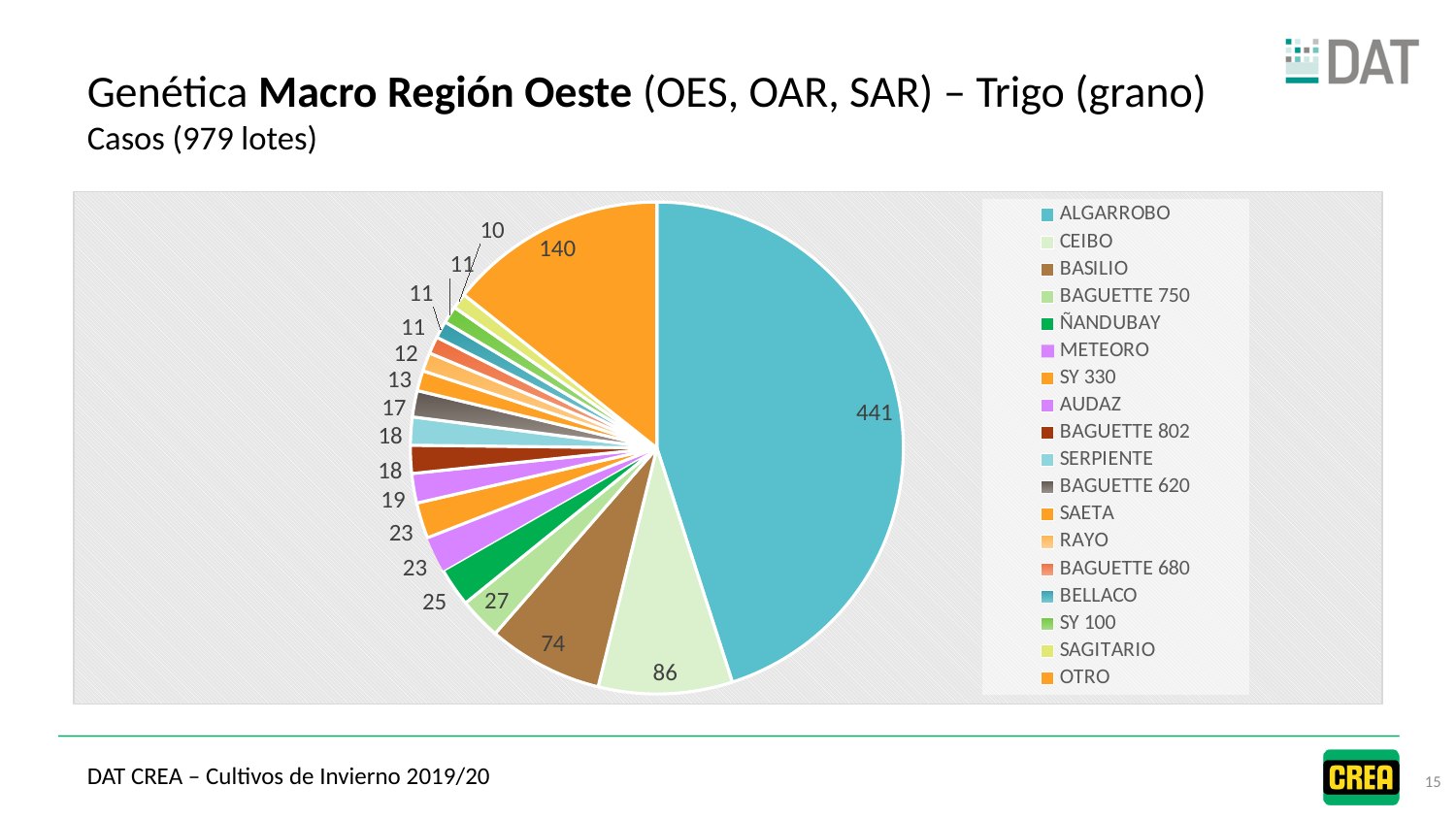
What is the value of the OTRO slice? 140 Which variety has the smallest slice of the pie? SAGITARIO What is the value for BASILIO? 74 Which variety has the largest slice of the pie? ALGARROBO What is the value for CEIBO in the pie chart? 86 How many categories does the legend of the pie chart list? 18 What is the total number of lotes stated in the slide subtitle? 979 lotes What is the difference between the values for OTRO and BASILIO? 66 What is the difference between the values for ALGARROBO and CEIBO? 355 Which is larger, the value for CEIBO or the value for BASILIO? CEIBO What type of chart is shown on the slide? pie chart How many cases (lotes) are shown for ALGARROBO? 441